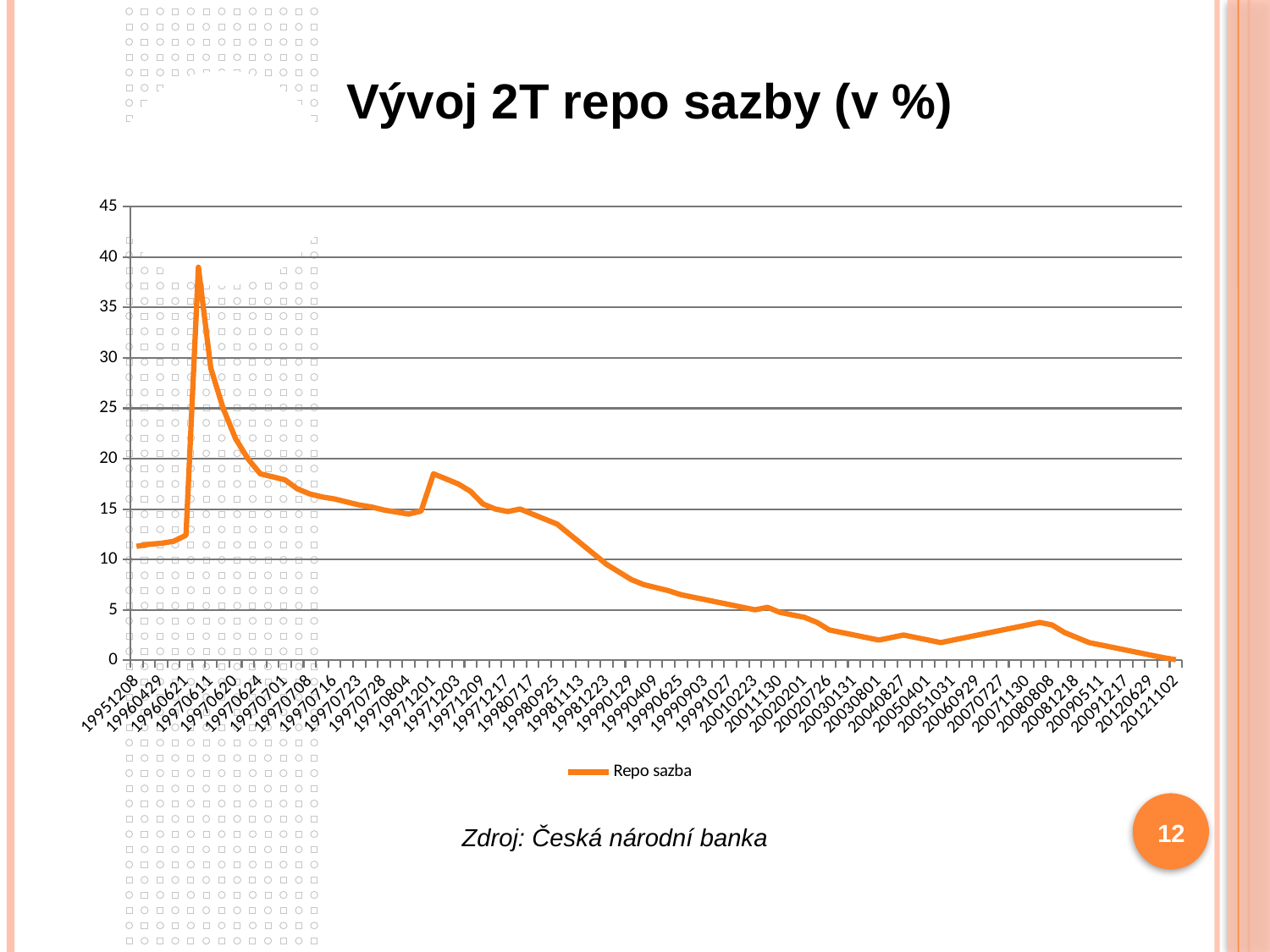
What is the title of the chart? Vývoj 2T repo sazby (v %) What kind of chart is shown on the slide? line chart At which x-axis date is the repo rate lowest? 20121102 Is the value for 19951208 greater or less than 15? less How many series does the legend list? 1 Is the value for 20080808 greater or less than 5? less From 20080808 to 20121102, do the values rise or fall along the x axis? fall Is the value for 19970611 greater or less than 35? less What is the name of the series shown in the legend? Repo sazba Which has the larger value, 19971201 or 19990129? 19971201